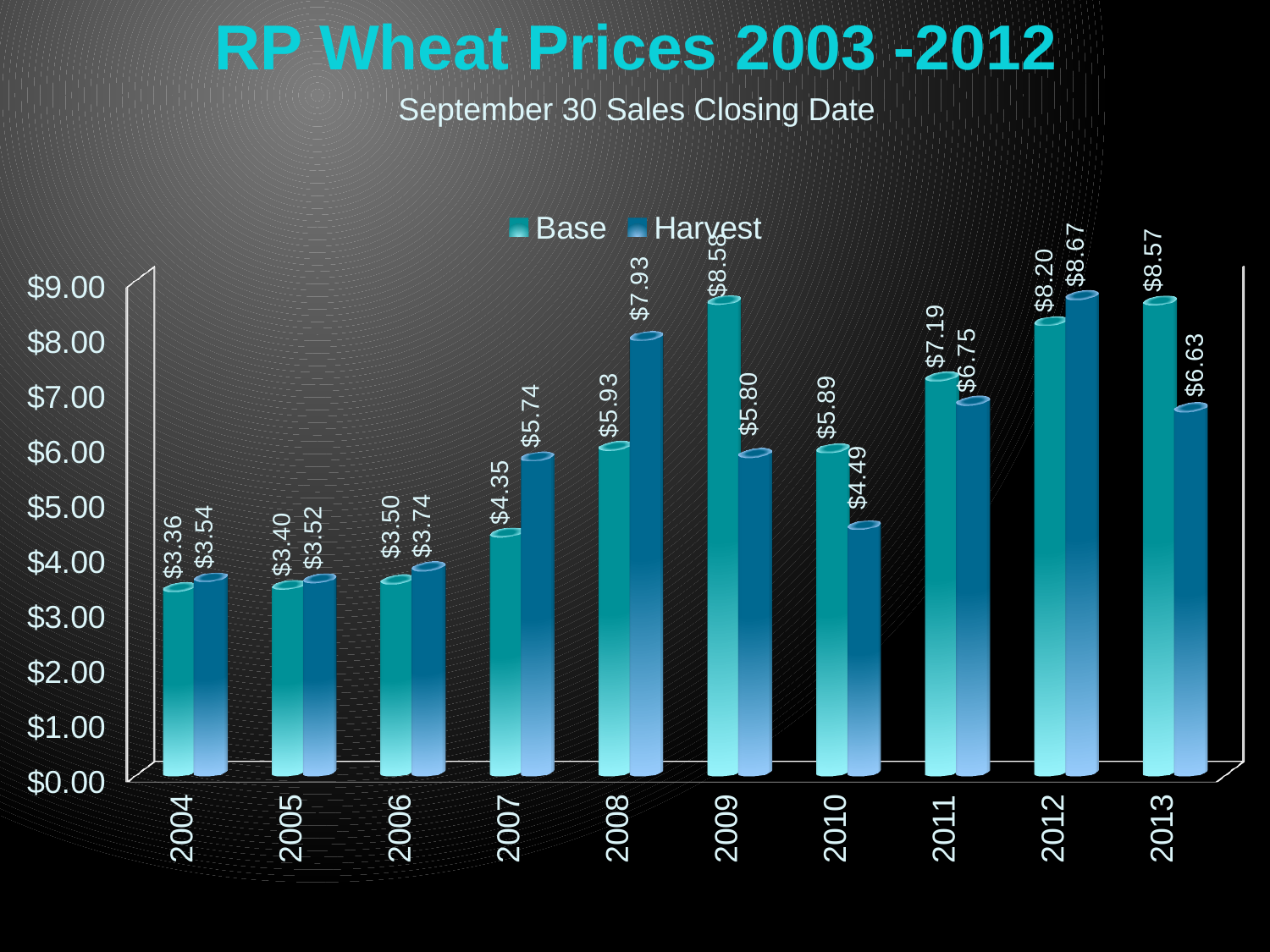
What is the Base price for 2009? $8.58 How many years are shown on the x axis? 10 Which year has the highest Harvest price? 2012 In 2008, which is larger, the Base price or the Harvest price? Harvest In 2010, which is larger, the Base price or the Harvest price? Base What is the difference between the Harvest and Base prices in 2012? $0.47 What is the difference between the Base and Harvest prices in 2009? $2.78 What is the Harvest price for 2012? $8.67 What is the Base price for 2007? $4.35 How many series does the legend list? 2 What kind of chart is shown on the slide? Bar chart What is the Harvest price for 2010? $4.49